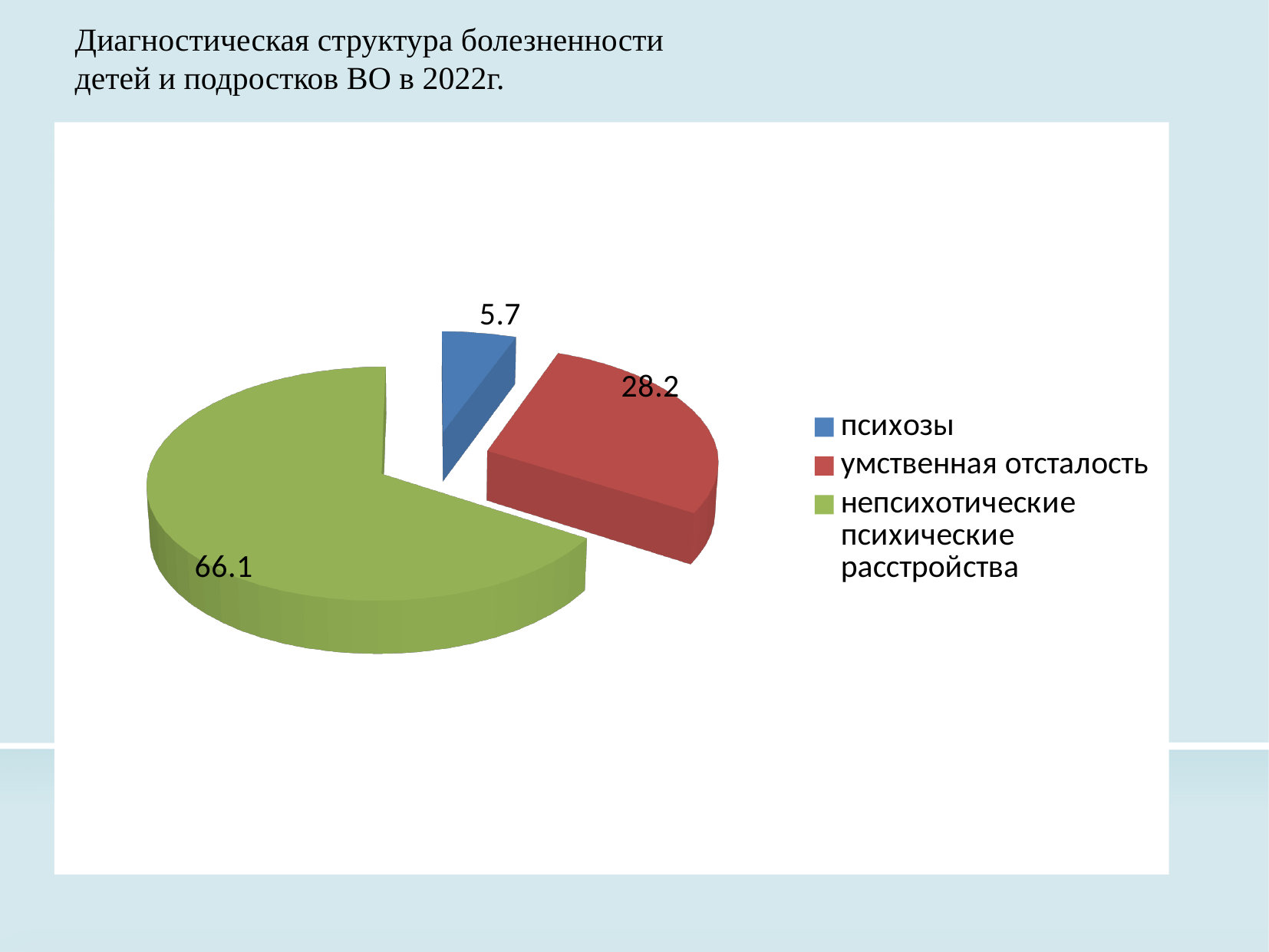
What type of chart is shown on the slide? pie chart Which category has the largest slice? непсихотические психические расстройства What is the value for умственная отсталость? 28.2 What is the value for психозы? 5.7 What colour is the slice for умственная отсталость? red What is the difference between the values for непсихотические психические расстройства and умственная отсталость? 37.9 Which is larger, the value for умственная отсталость or the value for психозы? умственная отсталость What is the value for непсихотические психические расстройства? 66.1 How many slices does the pie chart have? 3 Which category has the smallest slice? психозы What is the difference between the values for умственная отсталость and психозы? 22.5 What is the title of the slide? Диагностическая структура болезненности детей и подростков ВО в 2022г.